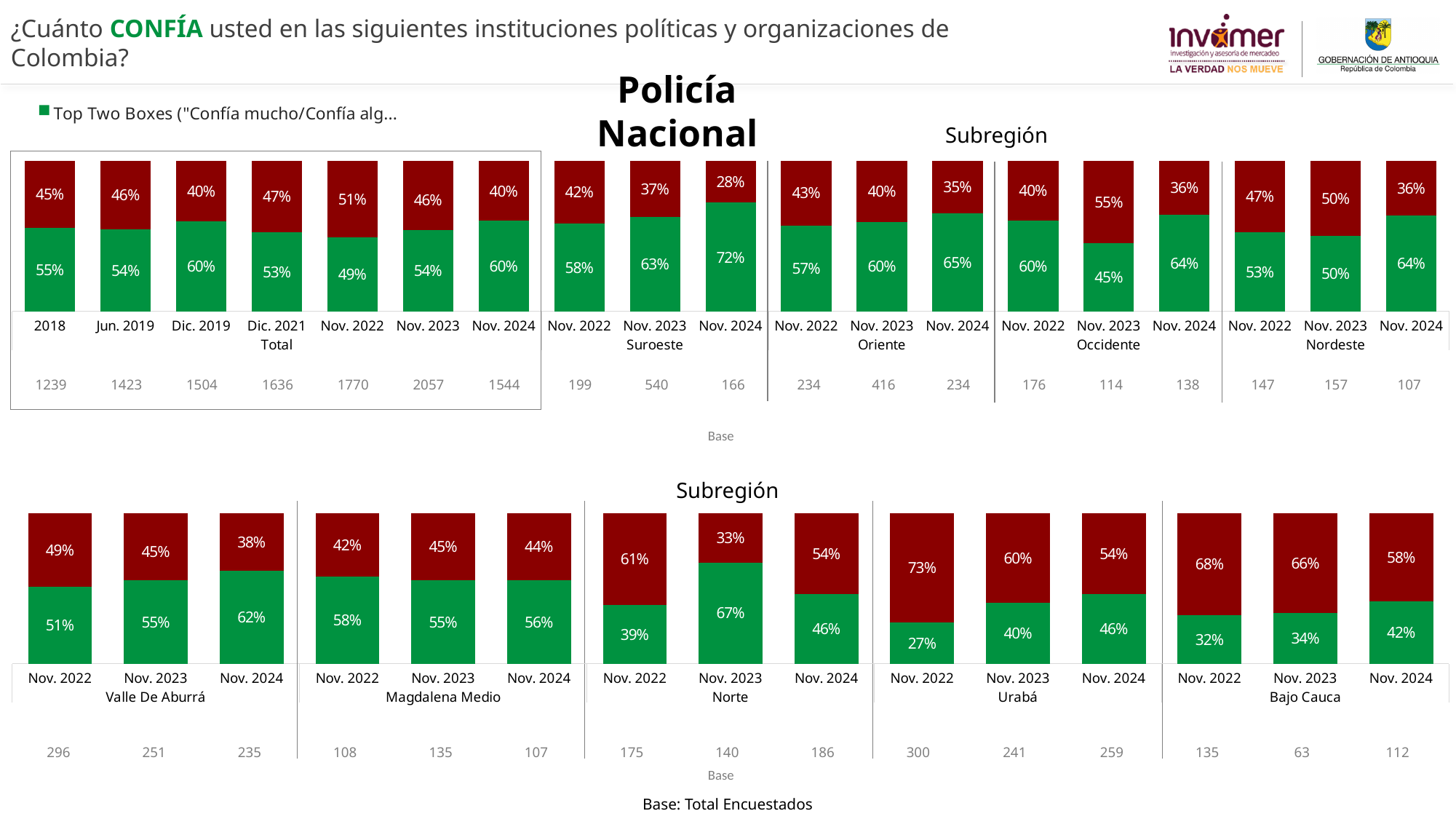
In the top chart, which Suroeste period has the highest green (Top Two Boxes) value? Nov. 2024 In the bottom chart, what is the total of the two stacked segments for Norte in Nov. 2023? 100% In the bottom chart, how does the green (Top Two Boxes) value for Valle De Aburrá change from Nov. 2022 to Nov. 2024? It rises In the top chart, what is the red segment value for Suroeste in Nov. 2024? 28% In the top chart, what is the base (number of respondents) for Total in Nov. 2023? 2057 In the top chart, which is larger: the green value for Oriente in Nov. 2024 or for Nordeste in Nov. 2023? Oriente Nov. 2024 In the bottom chart, which subregion has the lowest green value in Nov. 2024? Bajo Cauca In the bottom chart, what is the green (Top Two Boxes) value for Urabá in Nov. 2022? 27% What type of chart is shown on the slide? Stacked bar chart In the top chart, what is the difference between the green values for Occidente in Nov. 2024 and Nov. 2023? 19 percentage points In the top chart, which Total period has the lowest green (Top Two Boxes) value? Nov. 2022 In the top chart, what is the green (Top Two Boxes) value for Total in Nov. 2024? 60%